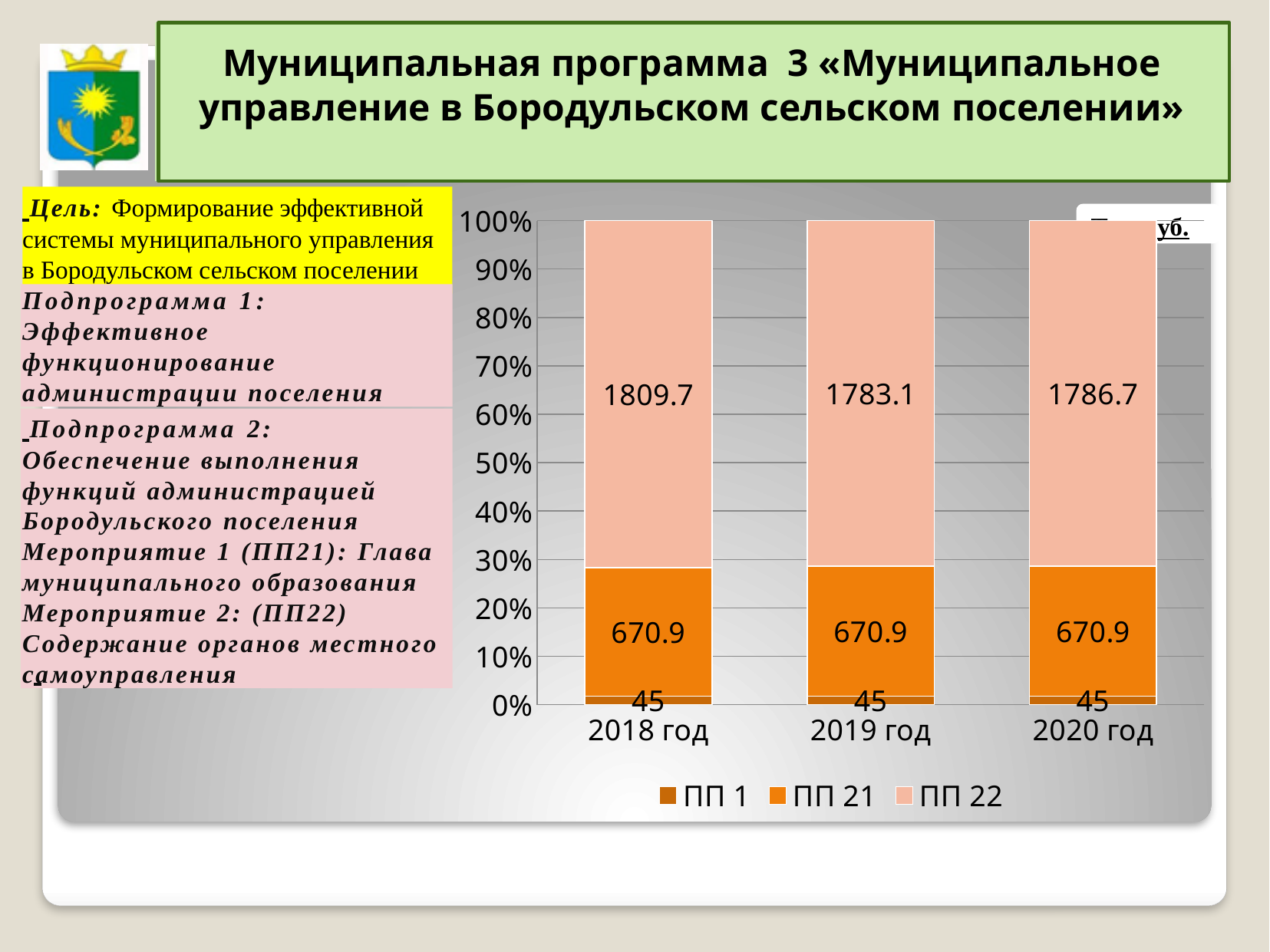
What kind of chart is shown on the slide? Stacked bar chart What is the value of ПП 1 for 2019 год? 45 How many series does the legend list? 3 In which year is the value of ПП 22 the highest? 2018 год What is the value of ПП 22 for 2018 год? 1809.7 What is the value of ПП 21 for 2020 год? 670.9 What is the value of ПП 22 for 2019 год? 1783.1 What is the difference between the ПП 22 values for 2018 год and 2019 год? 26.6 How many years are shown on the x axis? 3 In which year is the value of ПП 22 the lowest? 2019 год What is the total of the stacked bar for 2018 год? 2525.6 Which is larger: the ПП 22 value for 2020 год or for 2019 год? 2020 год